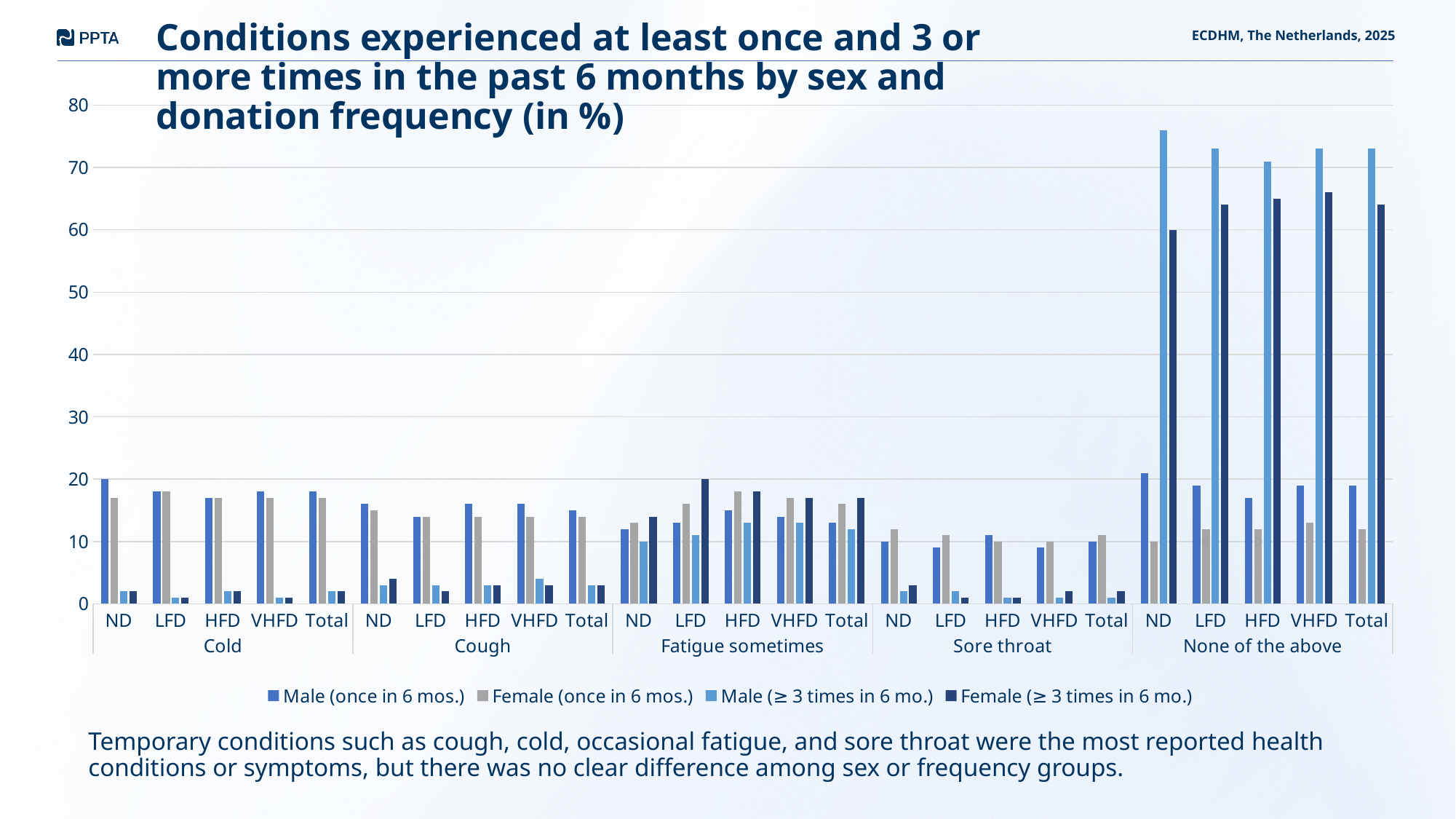
Which colour represents the Female (once in 6 mos.) series? grey Is the value for Female (≥ 3 times in 6 mo.) at ND under 'None of the above' greater or less than 70? less Which condition group has the tallest bars in the chart? None of the above What kind of chart is shown on the slide? bar chart How many series does the legend list? 4 How many donation frequency categories are shown within each condition group? 5 Is the value for Male (once in 6 mos.) at LFD under 'Fatigue sometimes' greater or less than 20? less How many condition groups are shown along the x axis? 5 What source and year are given in the top right corner of the slide? ECDHM, The Netherlands, 2025 Is the value for Female (once in 6 mos.) at ND under 'Cold' greater or less than 20? less Under 'None of the above' at ND, which is larger: Male (≥ 3 times in 6 mo.) or Female (≥ 3 times in 6 mo.)? Male (≥ 3 times in 6 mo.)